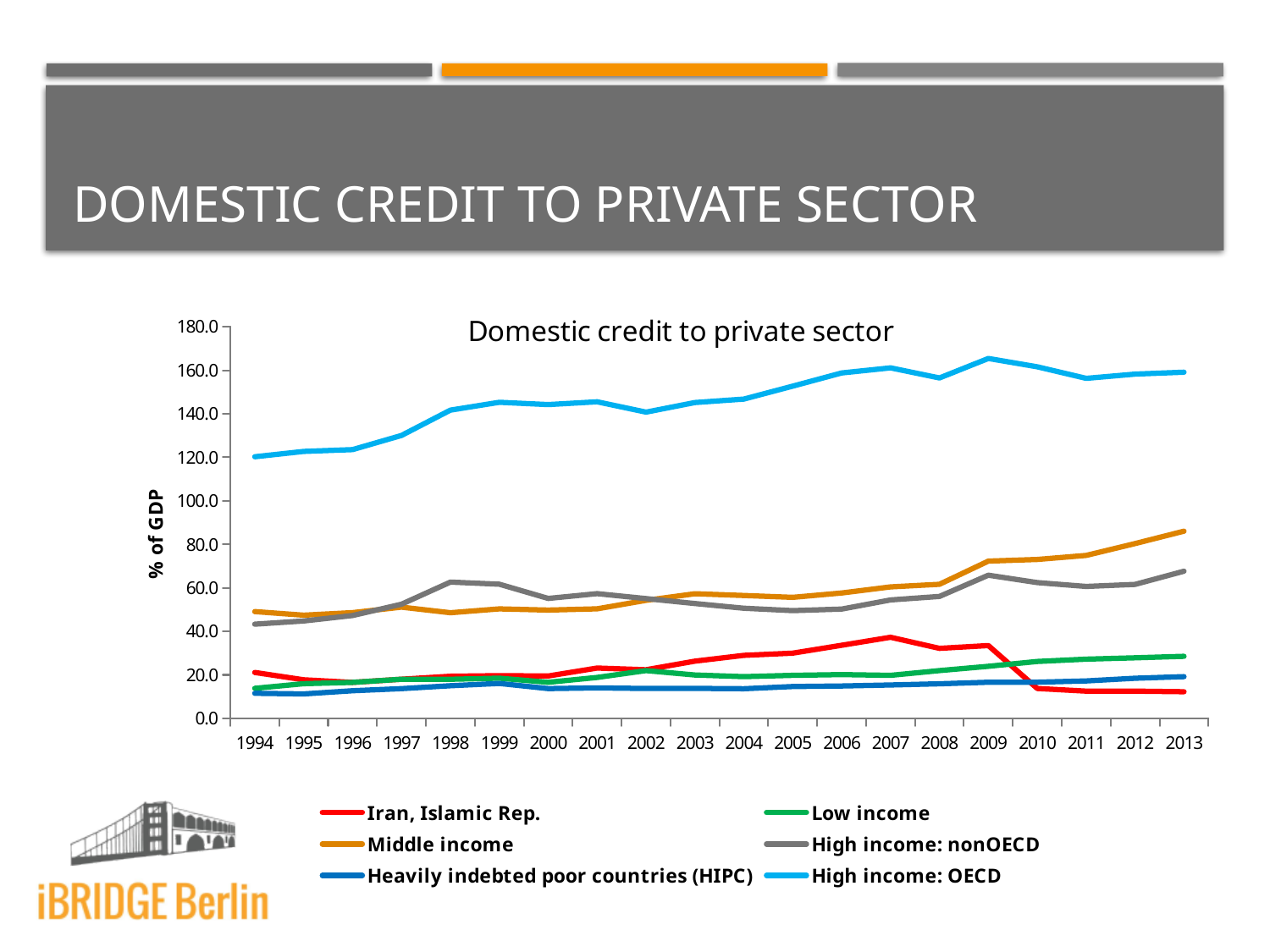
What is the label on the y axis? % of GDP Is the value for Middle income in 2013 greater or less than 80.0? greater Does the High income: OECD series rise or fall overall from 1994 to 2013? rise Which series has the highest value in 2013? High income: OECD What is the title of the chart? Domestic credit to private sector Which is larger in 2013, Middle income or High income: nonOECD? Middle income How many years are shown along the x axis? 20 How many series does the legend list? 6 Which series has the lowest value in 2013? Iran, Islamic Rep. Is the value for High income: OECD in 2009 greater or less than 160.0? greater What kind of chart is shown on the slide? line chart Is the value for Iran, Islamic Rep. in 2013 greater or less than 20.0? less